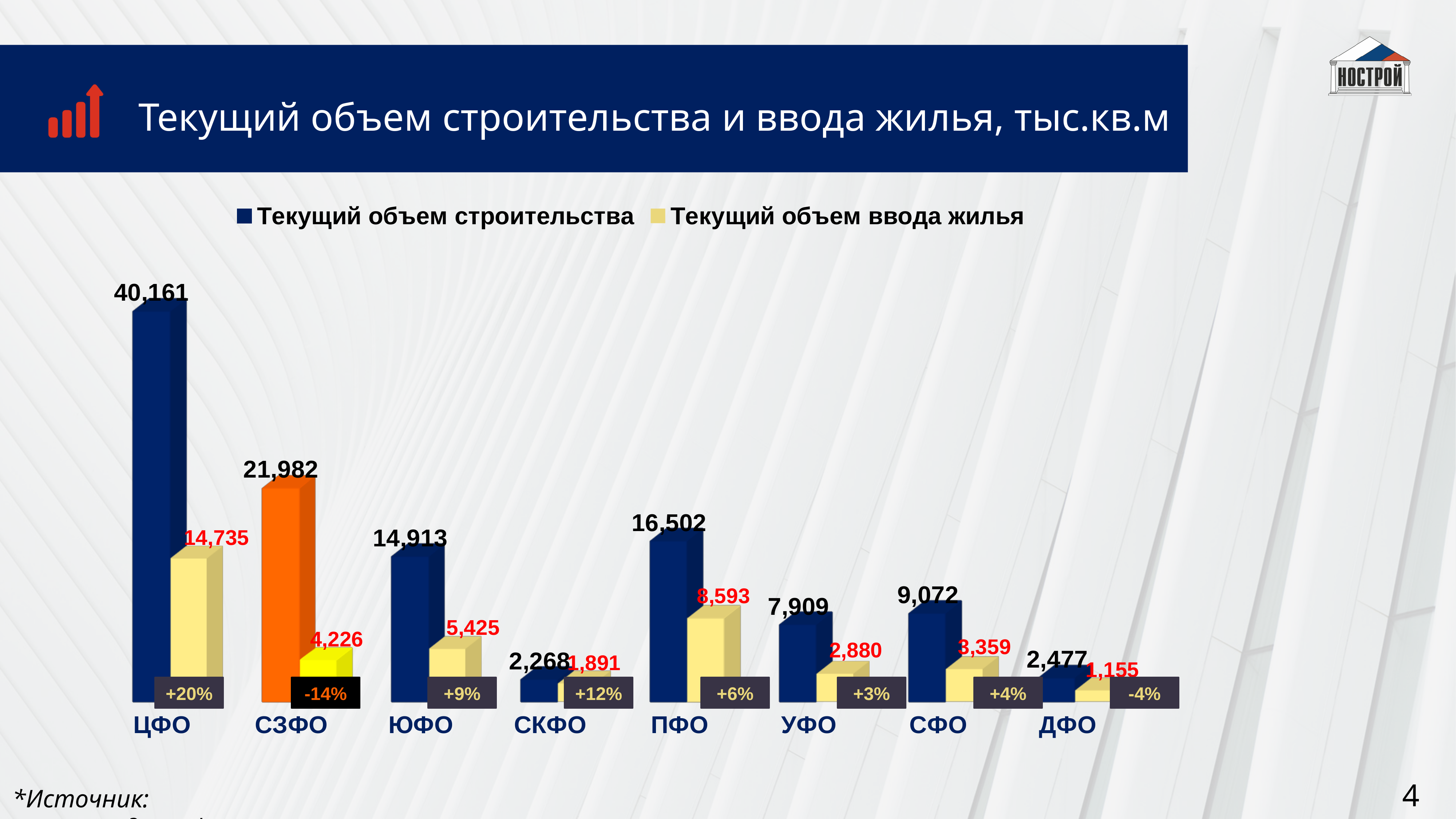
Which is larger: Текущий объем строительства for ПФО or for ЮФО? ПФО How many regions are shown on the x axis? 8 What is the value of Текущий объем ввода жилья for СЗФО? 4,226 Which region has the highest value of Текущий объем строительства? ЦФО What is the title of the slide? Текущий объем строительства и ввода жилья, тыс.кв.м How many series does the legend list? 2 What percentage change is shown for СЗФО? -14% What is the value of Текущий объем строительства for ЦФО? 40,161 What is the difference between the Текущий объем строительства values for ЦФО and СЗФО? 18,179 What is the value of Текущий объем ввода жилья for ПФО? 8,593 What kind of chart is shown on the slide? Bar chart Which region has the lowest value of Текущий объем ввода жилья? ДФО